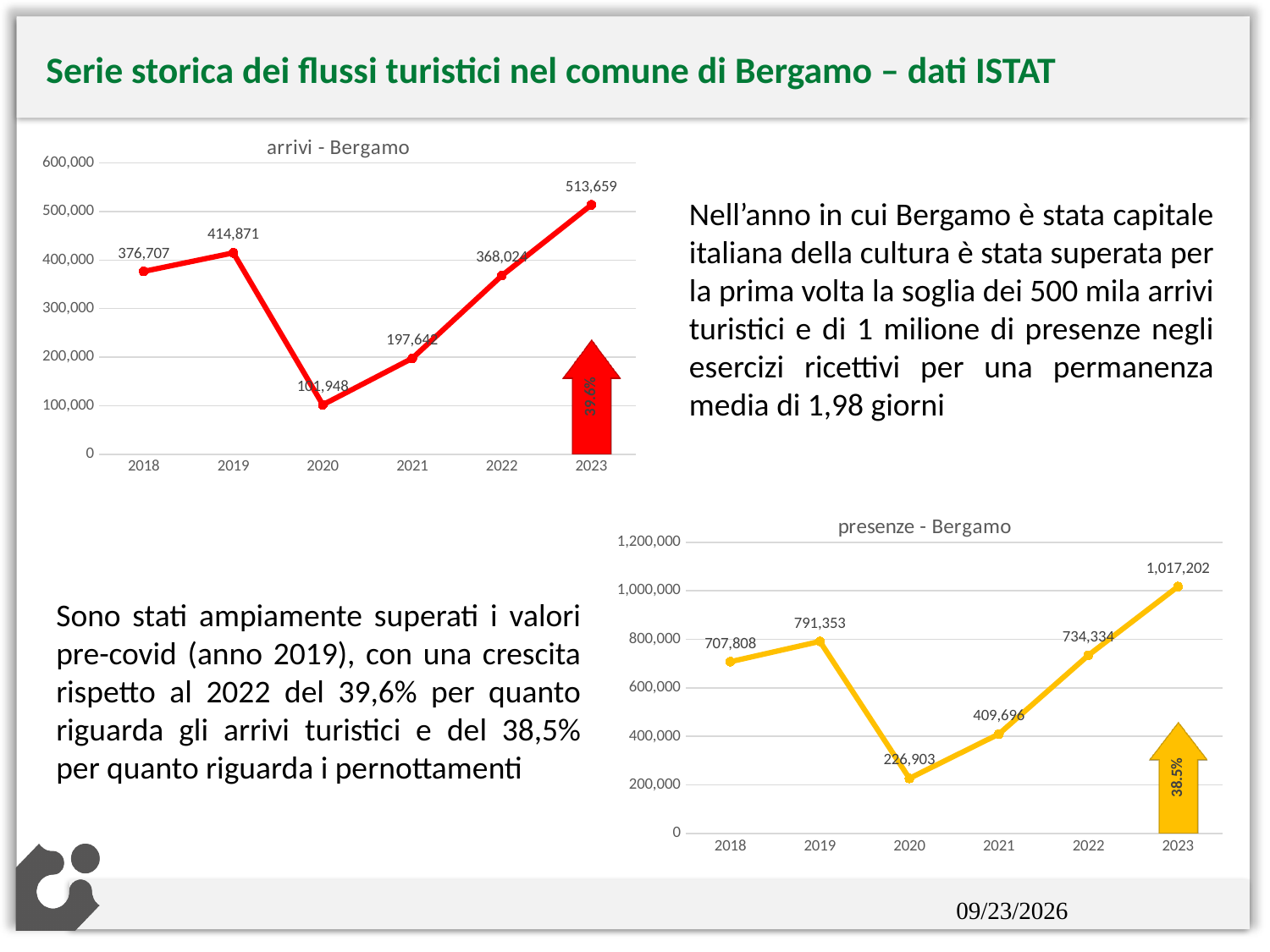
In the 'arrivi - Bergamo' chart, is the value for 2020 greater or less than 200,000? less In the 'presenze - Bergamo' chart, what is the value for 2023? 1,017,202 In the 'arrivi - Bergamo' chart, which is larger, the value for 2018 or the value for 2019? 2019 In the 'arrivi - Bergamo' chart, what is the difference between the 2023 and 2022 values? 145,635 In the 'arrivi - Bergamo' chart, what is the value for 2023? 513,659 In the 'arrivi - Bergamo' chart, which year has the highest value? 2023 How many years are plotted in the 'presenze - Bergamo' chart? 6 In the 'presenze - Bergamo' chart, which year has the lowest value? 2020 In the 'arrivi - Bergamo' chart, which year has the lowest value? 2020 In the 'presenze - Bergamo' chart, what is the value for 2019? 791,353 What kind of chart is the 'arrivi - Bergamo' chart? line chart In the 'presenze - Bergamo' chart, what is the difference between the 2023 and 2022 values? 282,868